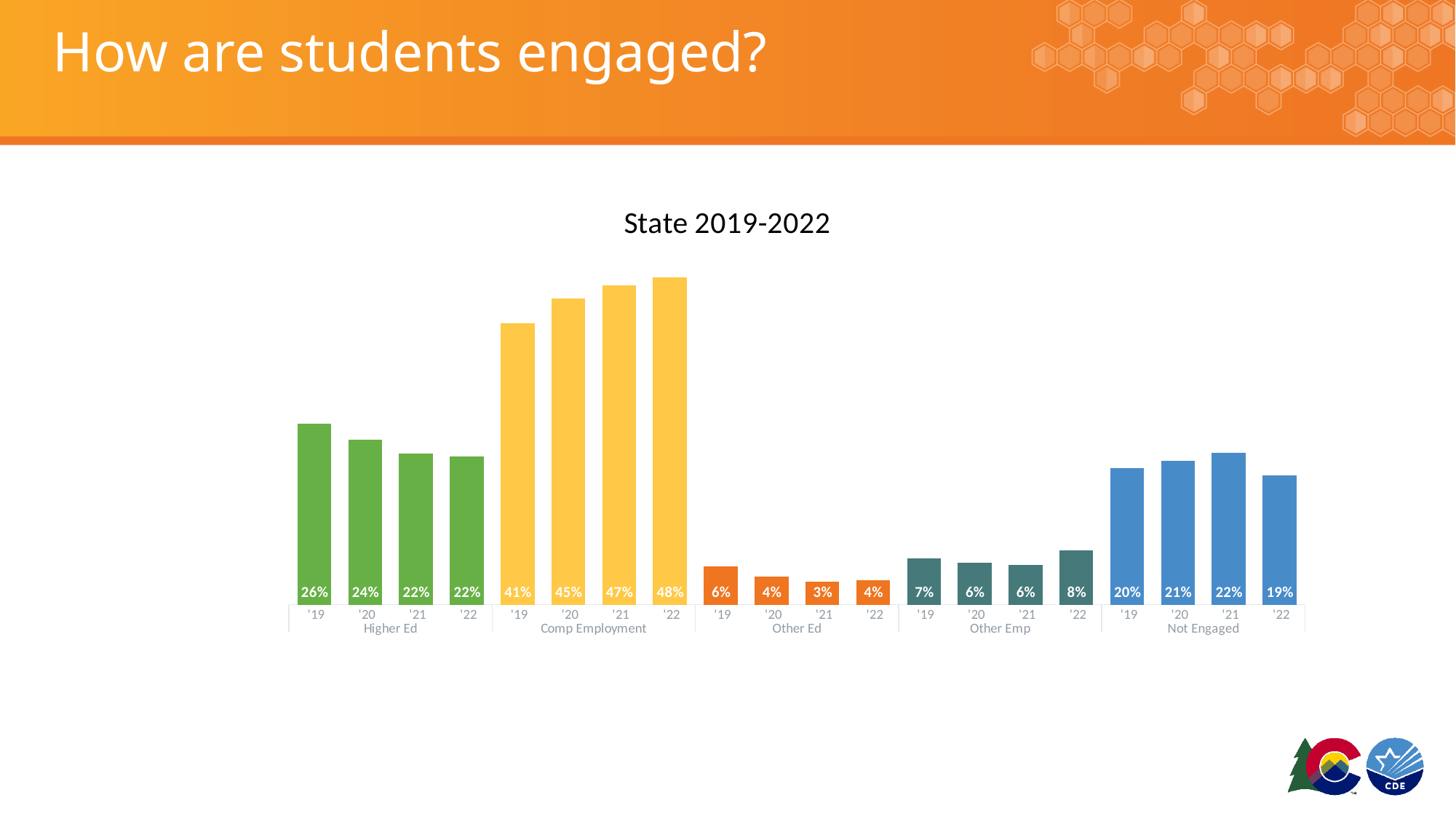
What is the value for Other Ed in '21? 3% What is the value for Higher Ed in '19? 26% Which bar has the highest value on the chart? Comp Employment '22 What is the value for Comp Employment in '22? 48% Which bar has the lowest value on the chart? Other Ed '21 What is the value for Not Engaged in '21? 22% What kind of chart is shown on the slide? Bar chart How many bars are plotted on the chart? 20 Which is larger, Higher Ed in '19 or Not Engaged in '19? Higher Ed in '19 Do the Comp Employment values rise or fall from '19 to '22? Rise What is the difference between Comp Employment in '22 and Comp Employment in '19? 7% What is the title of the chart? State 2019-2022